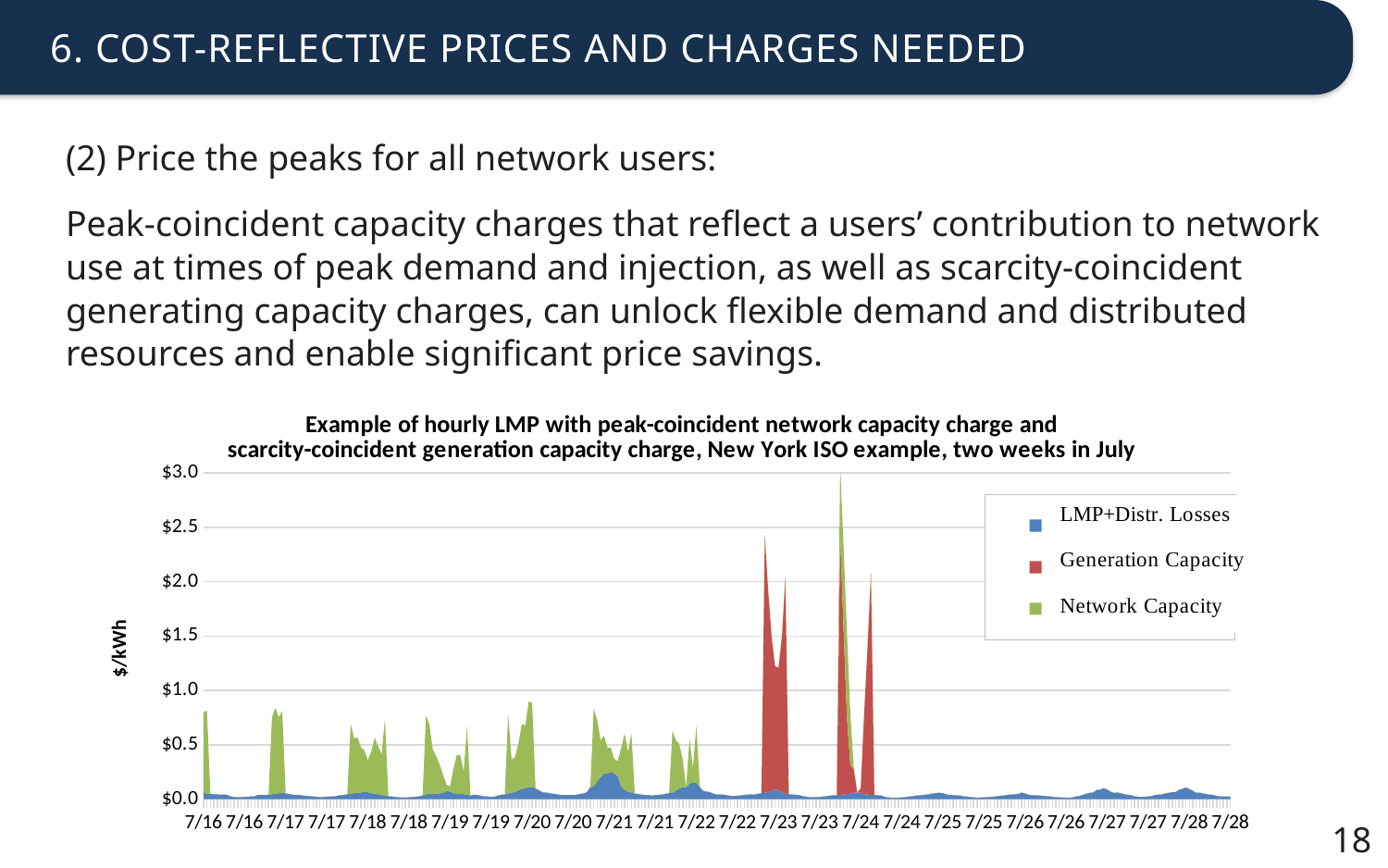
Is the tallest Generation Capacity spike on 7/23 greater or less than $2.0? greater What kind of chart is shown on the slide? Stacked area chart Is the tallest Network Capacity spike on 7/24 greater or less than $2.5? greater Which series has the tallest spike in the chart, Generation Capacity or Network Capacity? Generation Capacity Are the Network Capacity peaks during the first week (7/16 to 7/22) greater or less than $1.0? less How many series does the chart's legend list? 3 Which series is shown in green in the chart? Network Capacity Which series is shown in red in the chart? Generation Capacity What is the highest value shown on the vertical axis of the chart? $3.0 What is the unit shown on the vertical axis of the chart? $/kWh On which date does the chart's x axis begin? 7/16